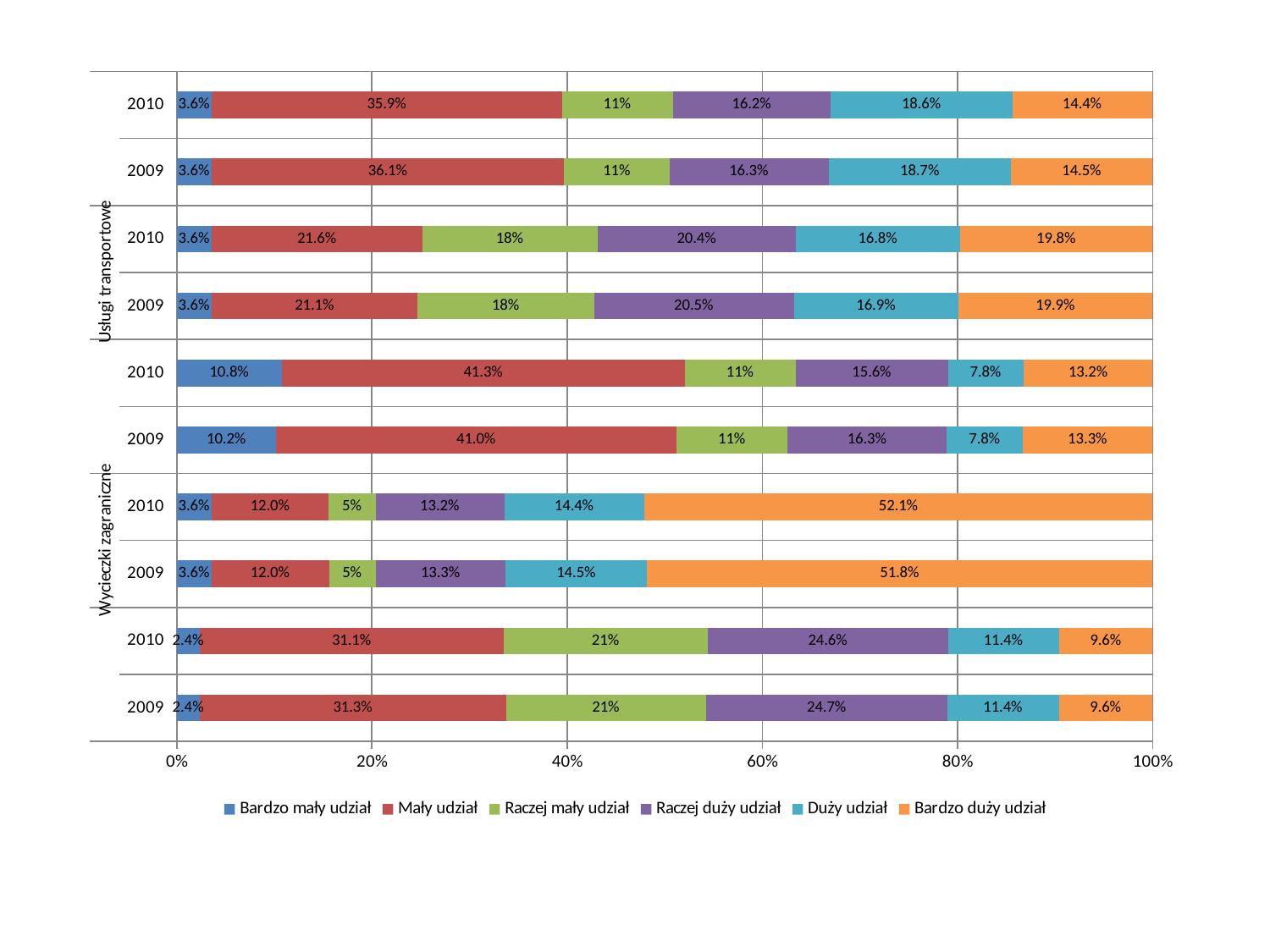
In the topmost bar (2010), what is the difference between the 'Duży udział' and 'Bardzo duży udział' segments? 4.2 percentage points In the bottom bar (2009), what is the value of the 'Raczej duży udział' segment? 24.7% How many bars are plotted on the chart? 10 What colour represents the 'Bardzo duży udział' series? Orange How many series does the legend list? 6 What is the largest single segment value printed anywhere on the chart? 52.1% In the bottom bar (2009), which segment is larger: 'Raczej mały udział' or 'Duży udział'? Raczej mały udział In the topmost bar (2010), what is the value of the 'Mały udział' segment? 35.9% In the bottom bar (2009), what is the value of the 'Bardzo mały udział' segment? 2.4% What kind of chart is shown on the slide? Stacked bar chart In the bottom bar (2009), which series has the largest segment? Mały udział What is the first entry listed in the legend? Bardzo mały udział